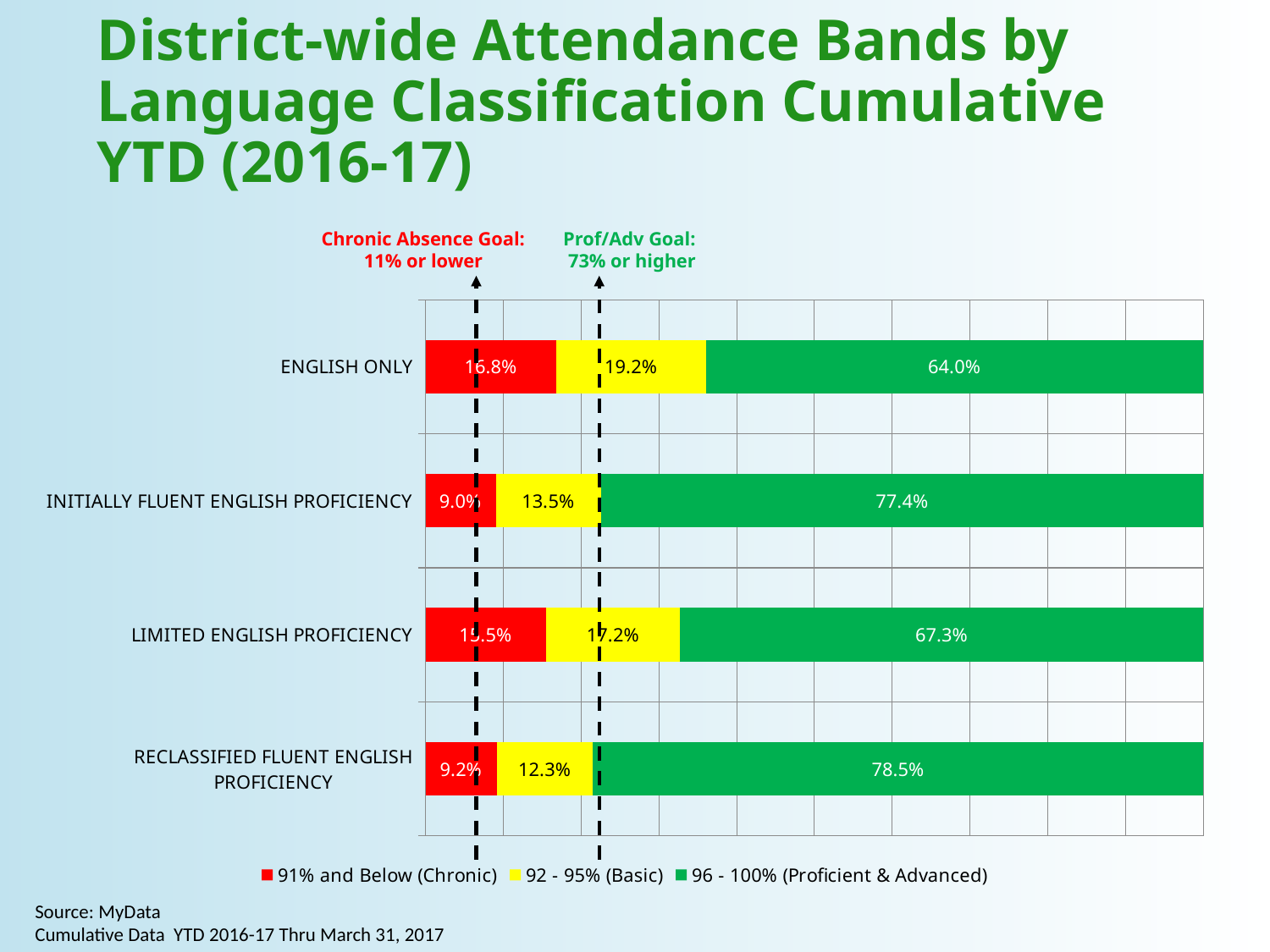
What is the 96 - 100% (Proficient & Advanced) value for ENGLISH ONLY? 64.0% What kind of chart is shown on the slide? Stacked bar chart How many language classification categories are plotted on the chart? 4 What is the 91% and Below (Chronic) value for RECLASSIFIED FLUENT ENGLISH PROFICIENCY? 9.2% Which category has the lowest 96 - 100% (Proficient & Advanced) value? ENGLISH ONLY What is the 92 - 95% (Basic) value for INITIALLY FLUENT ENGLISH PROFICIENCY? 13.5% What is the 96 - 100% (Proficient & Advanced) value for LIMITED ENGLISH PROFICIENCY? 67.3% According to the annotation on the chart, what is the Prof/Adv Goal? 73% or higher How many series does the chart legend list? 3 Which category has the highest 96 - 100% (Proficient & Advanced) value? RECLASSIFIED FLUENT ENGLISH PROFICIENCY Which is larger: the 92 - 95% (Basic) value for ENGLISH ONLY or for RECLASSIFIED FLUENT ENGLISH PROFICIENCY? ENGLISH ONLY What is the difference between the 96 - 100% (Proficient & Advanced) values for RECLASSIFIED FLUENT ENGLISH PROFICIENCY and ENGLISH ONLY? 14.5%